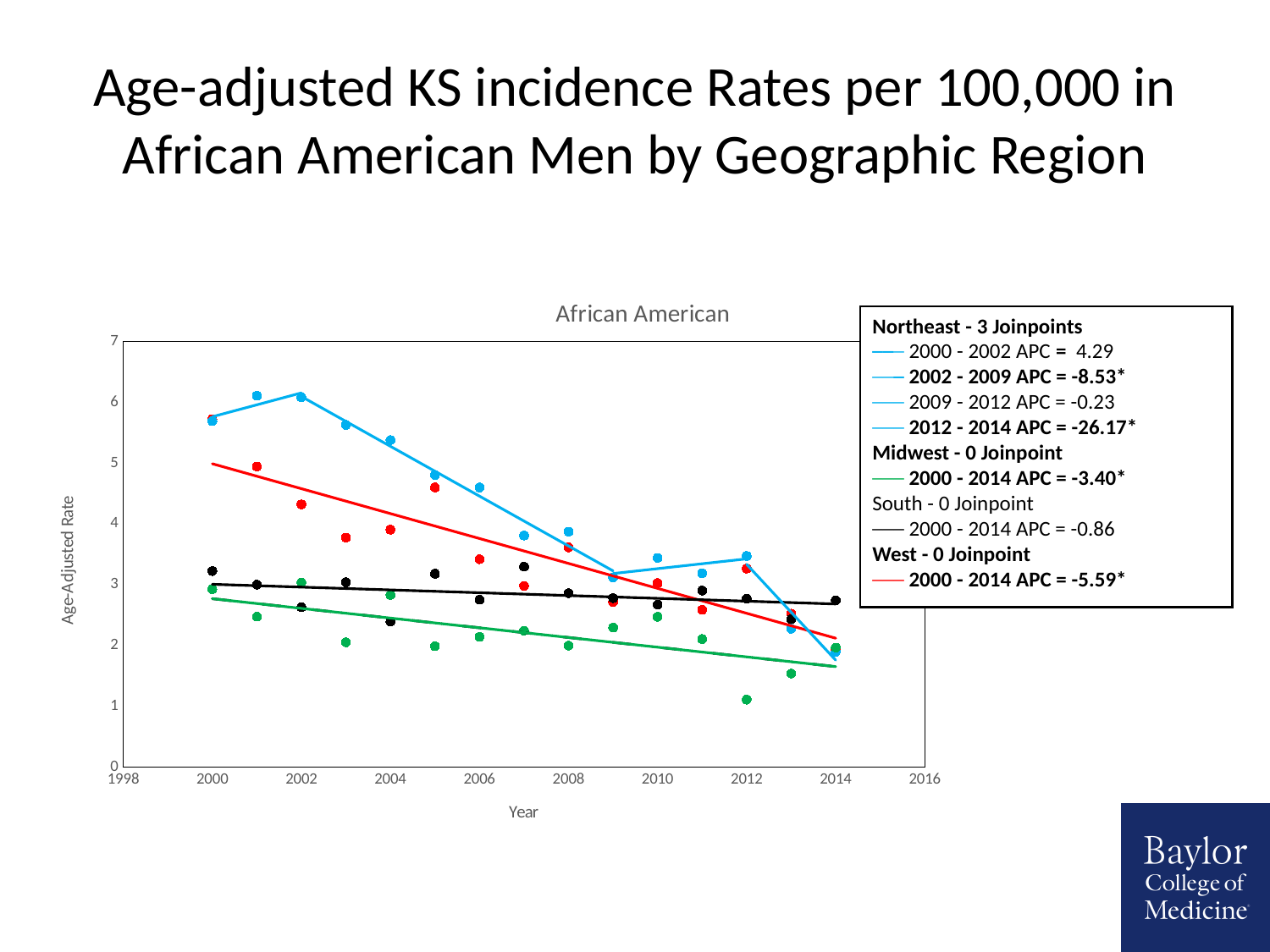
Is the Midwest value for 2012 greater or less than 2? less Is the Northeast value for 2000 greater or less than 5? greater What is the title printed above the plot area? African American What is the 2000 - 2014 APC for the West region? -5.59* What is the 2012 - 2014 APC for the Northeast region? -26.17* How many joinpoints does the legend give for the Northeast region? 3 How many geographic regions are listed in the legend box? 4 Which region has the lowest age-adjusted rate in 2012? Midwest What is the 2000 - 2014 APC for the Midwest region? -3.40* Does the Northeast fitted line rise or fall between 2002 and 2009? fall What kind of chart is shown on the slide? line chart